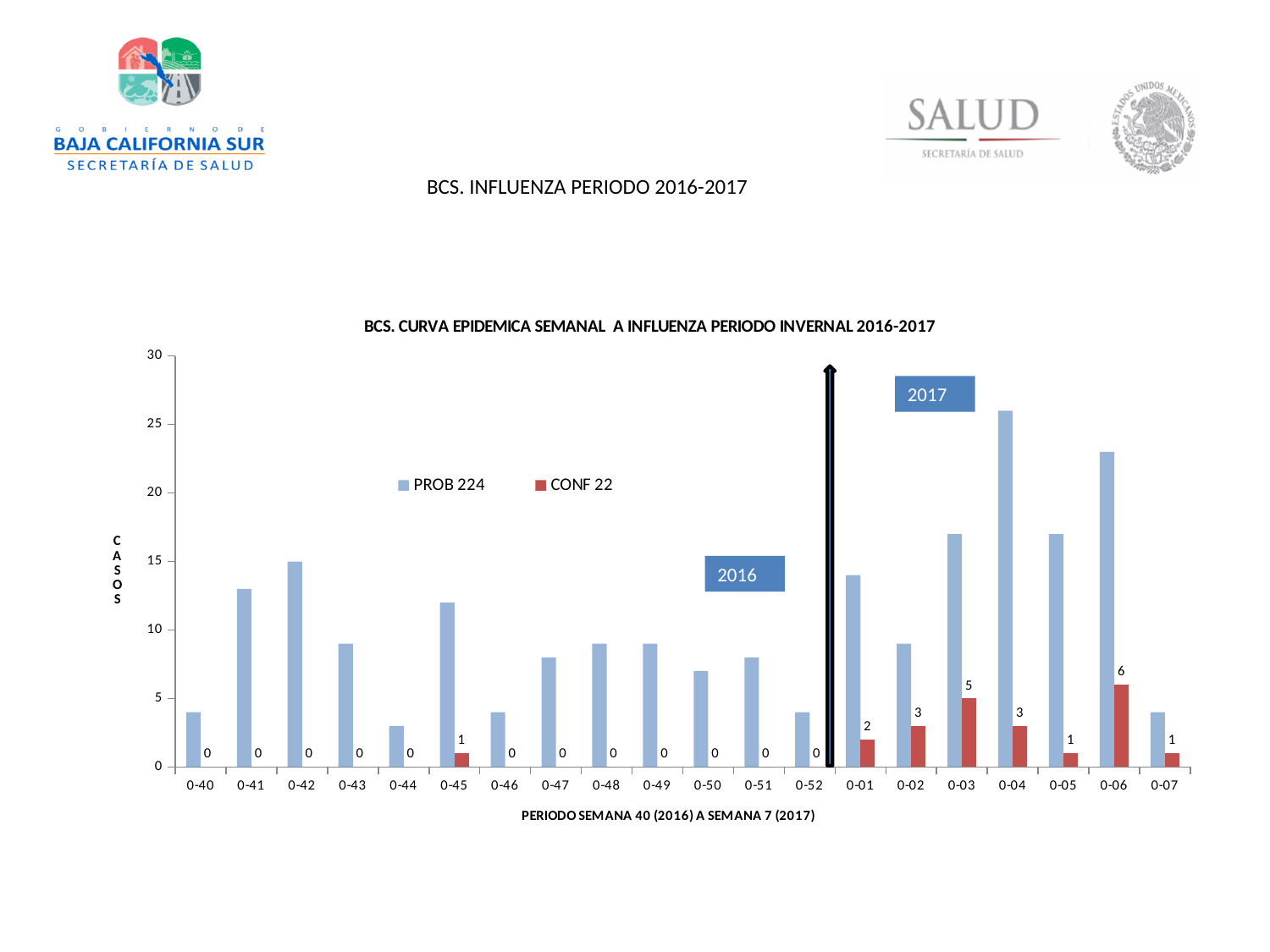
Which week has the highest CONF 22 value? 0-06 What is the CONF 22 value for week 0-06? 6 What is the difference between the CONF 22 values for weeks 0-06 and 0-03? 3 Is the PROB 224 value for week 0-04 greater or less than 25? greater What is the CONF 22 value for week 0-03? 5 Which week has the highest PROB 224 value? 0-04 Is the PROB 224 value for week 0-42 greater or less than 20? less Which is larger, the CONF 22 value for week 0-03 or for week 0-01? 0-03 What is the CONF 22 value for week 0-45? 1 How many weeks are shown on the x axis? 20 How many series does the legend list? 2 What kind of chart is shown? bar chart